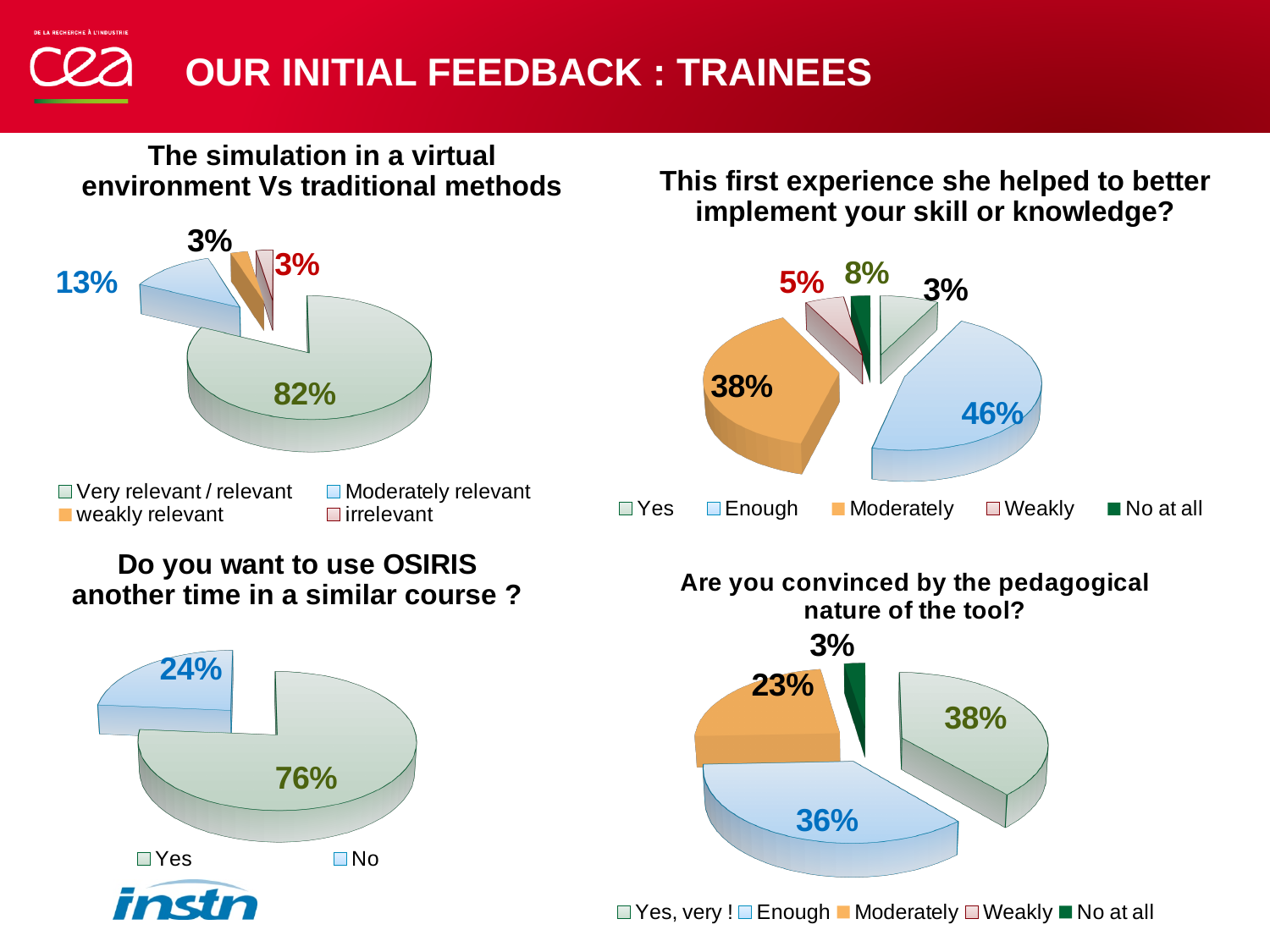
In the chart titled "The simulation in a virtual environment Vs traditional methods", what percentage is Very relevant / relevant? 82% In the chart titled "This first experience she helped to better implement your skill or knowledge?", how many entries does the legend list? 5 In the chart titled "Do you want to use OSIRIS another time in a similar course ?", what percentage answered No? 24% In the chart titled "This first experience she helped to better implement your skill or knowledge?", what percentage answered Enough? 46% In the chart titled "Are you convinced by the pedagogical nature of the tool?", what percentage answered Moderately? 23% In the chart titled "The simulation in a virtual environment Vs traditional methods", what percentage is Moderately relevant? 13% In the chart titled "This first experience she helped to better implement your skill or knowledge?", what percentage answered Moderately? 38% In the chart titled "Do you want to use OSIRIS another time in a similar course ?", what percentage answered Yes? 76% In the chart titled "The simulation in a virtual environment Vs traditional methods", which category has the largest share? Very relevant / relevant In the chart titled "Are you convinced by the pedagogical nature of the tool?", which is larger, Yes, very ! or Enough? Yes, very ! In the chart titled "This first experience she helped to better implement your skill or knowledge?", what is the difference between the Enough and Moderately shares? 8% What type of chart is used for "Do you want to use OSIRIS another time in a similar course ?"? Pie chart